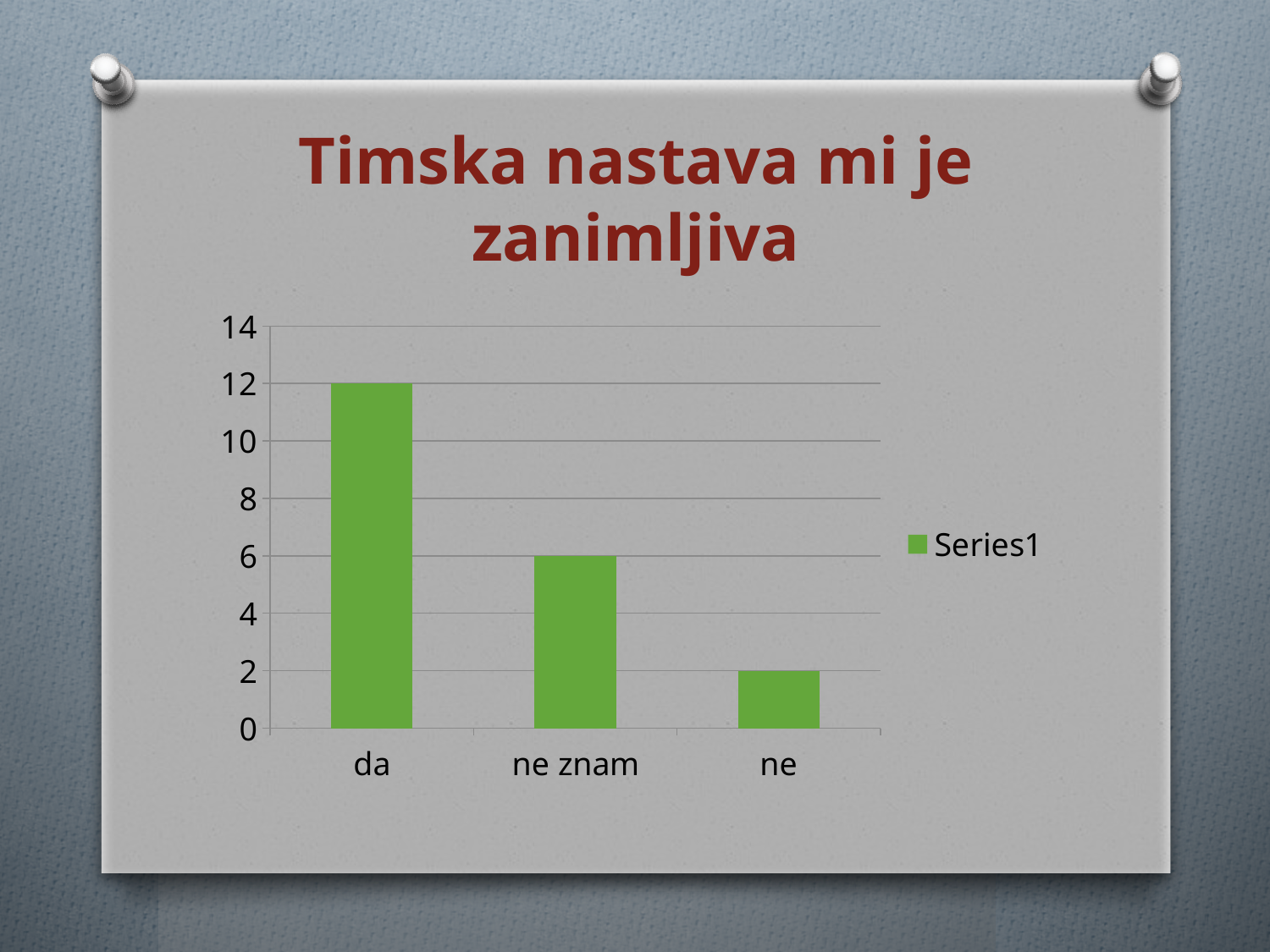
What is the value for "ne znam"? 6 Which category has the highest value? da How many categories are shown on the x axis? 3 What is the value for "ne"? 2 What is the difference between the values for "ne znam" and "ne"? 4 What kind of chart is shown on the slide? bar chart Which is larger, the value for "ne znam" or the value for "ne"? ne znam What is the difference between the values for "da" and "ne znam"? 6 Is the value for "da" greater or less than 10? greater What is the value for "da"? 12 What is the title of the chart? Timska nastava mi je zanimljiva Which category has the lowest value? ne